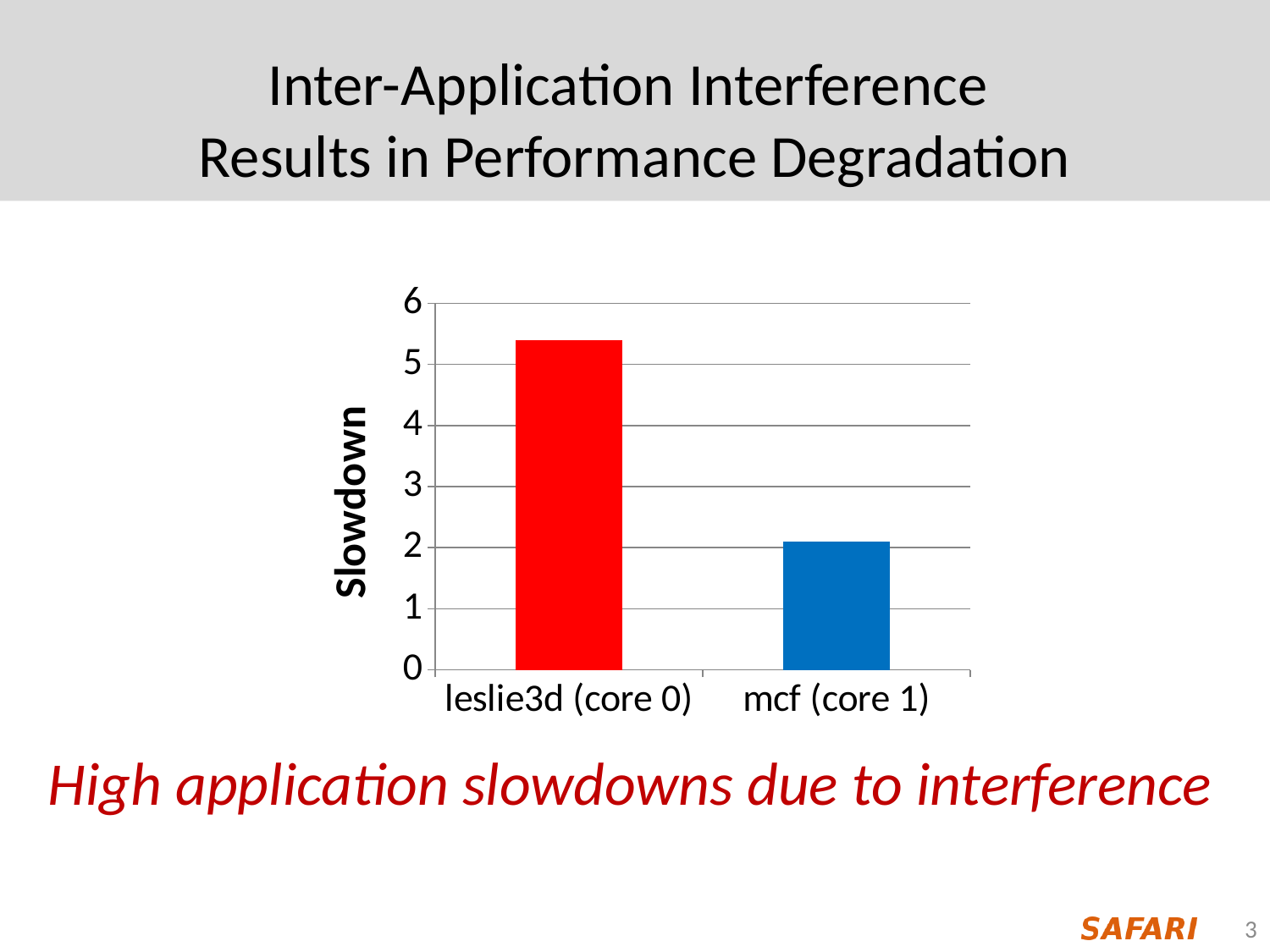
Is the slowdown for mcf (core 1) greater or less than 3? less What colour is the bar for leslie3d (core 0)? red How many categories are plotted in the chart? 2 What is the label of the vertical axis? Slowdown Is the slowdown for leslie3d (core 0) greater or less than 5? greater Is the slowdown for leslie3d (core 0) greater or less than 6? less What kind of chart is shown on the slide? bar chart Which category has the highest slowdown? leslie3d (core 0) Which has a larger slowdown, leslie3d (core 0) or mcf (core 1)? leslie3d (core 0) Which category has the lowest slowdown? mcf (core 1)